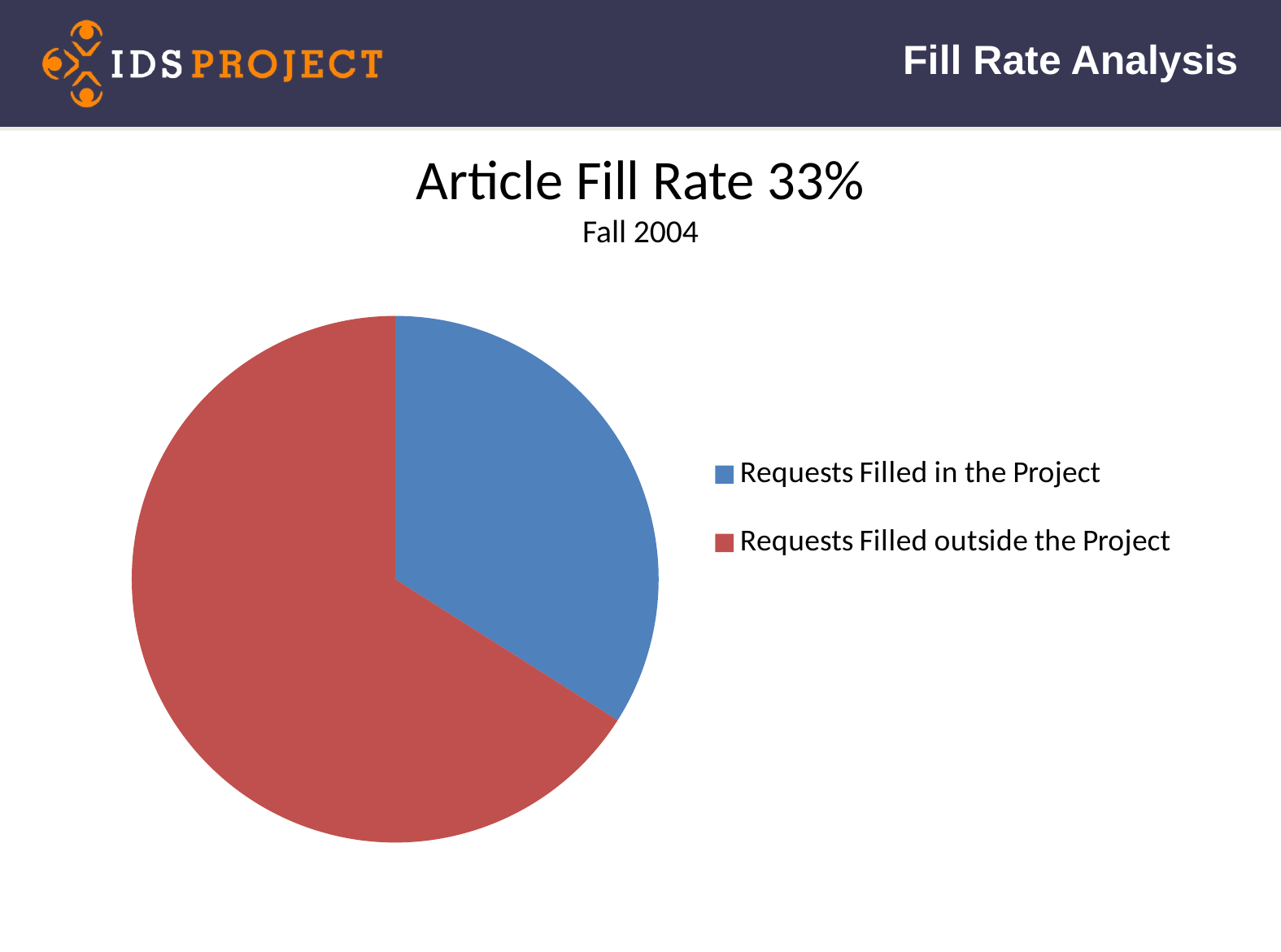
Which is larger in the pie chart: Requests Filled in the Project or Requests Filled outside the Project? Requests Filled outside the Project What kind of chart is shown on the slide? pie chart Which category has the smallest slice of the pie chart? Requests Filled in the Project What is the title of the pie chart? Article Fill Rate 33% How many slices does the pie chart have? 2 Which category has the largest slice of the pie chart? Requests Filled outside the Project Which colour represents Requests Filled in the Project in the pie chart? blue How many entries does the legend of the pie chart list? 2